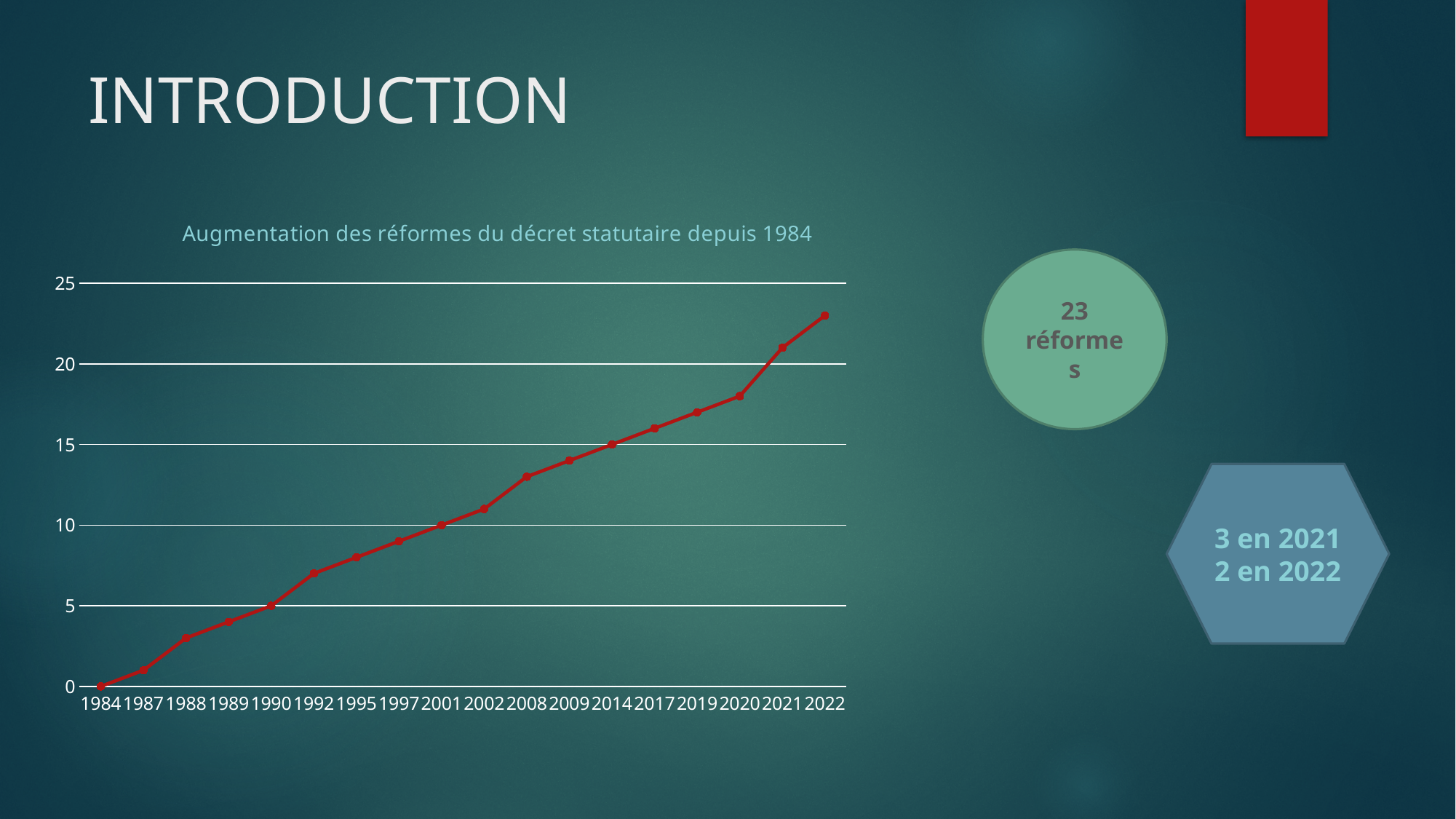
Which year has the larger value, 2020 or 1995? 2020 What is the value for 2001 in the chart? 10 Is the value for 2008 greater or less than 15? less How many years are plotted along the x axis of the chart? 18 Which year has the highest value in the chart? 2022 What is the value for 1990 in the chart? 5 What is the title of the chart? Augmentation des réformes du décret statutaire depuis 1984 What kind of chart is shown on the slide? Line chart Do the values in the chart rise or fall from 1984 to 2022? Rise Which year has the lowest value in the chart? 1984 Is the value for 2022 greater or less than 20? greater What is the value for 1984 in the chart? 0